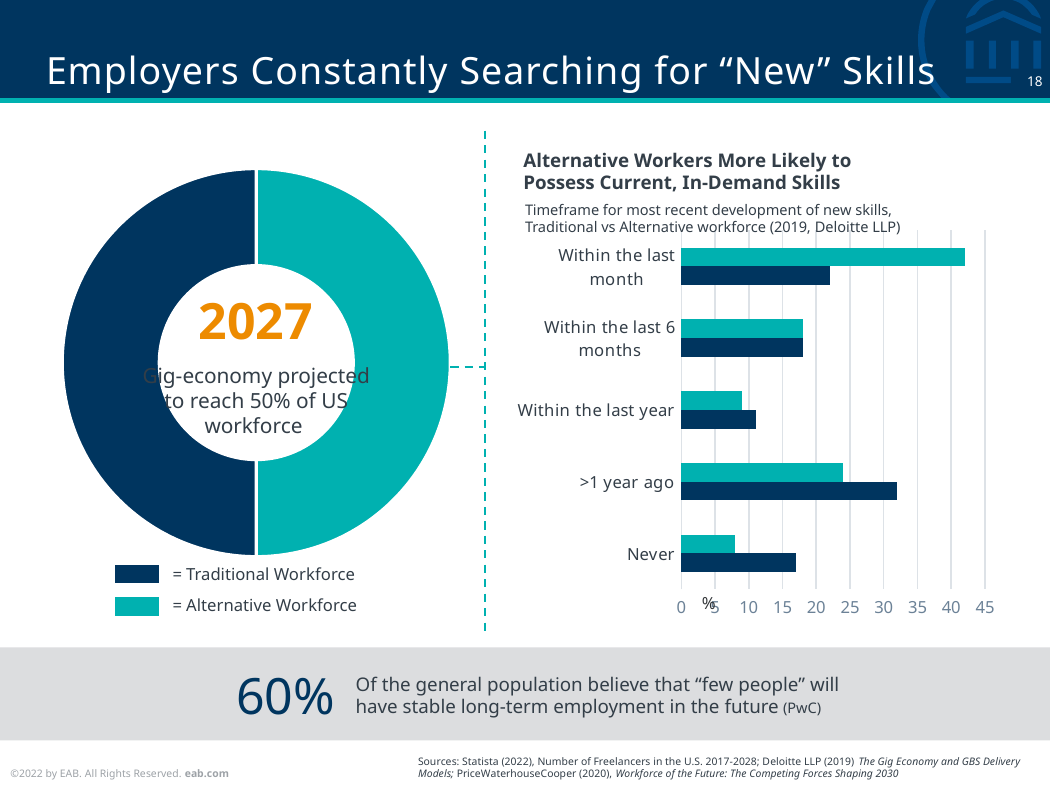
In the bar chart on the right, is the Traditional Workforce value for "Never" greater or less than 20? less In the bar chart on the right, which timeframe category has the lowest value for the Alternative Workforce? Never In the bar chart on the right, for ">1 year ago", which workforce has the larger value, Traditional or Alternative? Traditional Workforce In the bar chart on the right, how many timeframe categories are shown? 5 How many workforce series does the legend on the slide list? 2 In the bar chart on the right, for "Within the last month", which workforce has the larger value, Traditional or Alternative? Alternative Workforce Which colour represents the Alternative Workforce in the charts on the slide? teal What kind of chart is the chart on the left showing the 2027 gig-economy projection? donut chart In the bar chart on the right, which timeframe category has the highest value for the Alternative Workforce? Within the last month In the bar chart on the right, which timeframe category has the highest value for the Traditional Workforce? >1 year ago What kind of chart is the chart on the right titled "Alternative Workers More Likely to Possess Current, In-Demand Skills"? bar chart In the bar chart on the right, is the Alternative Workforce value for "Within the last month" greater or less than 40? greater